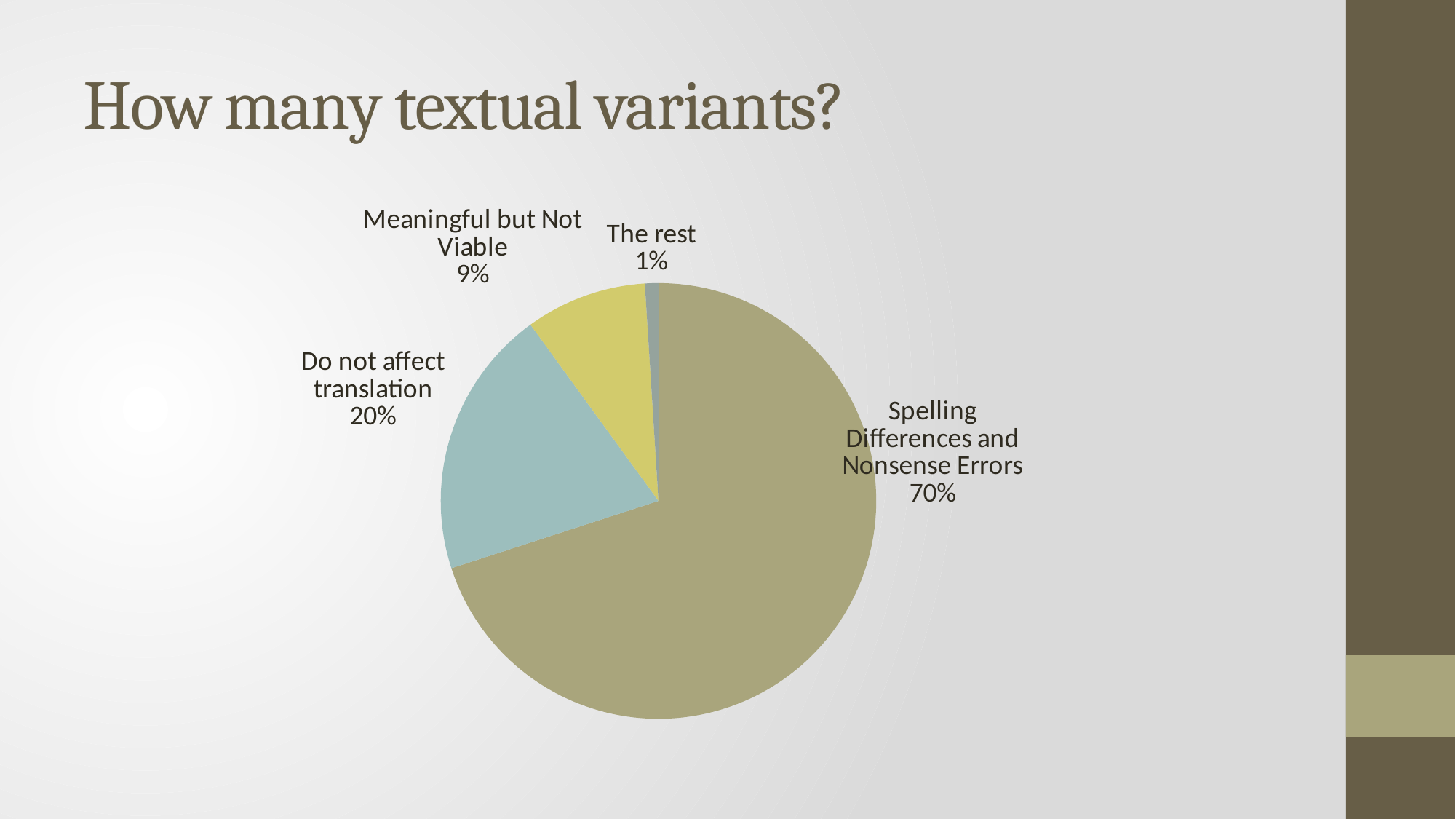
How many slices does the pie chart have? 4 Which slice of the pie is the largest? Spelling Differences and Nonsense Errors What is the difference in percentage points between 'Spelling Differences and Nonsense Errors' and 'Do not affect translation'? 50 Which is larger, the share for 'Meaningful but Not Viable' or the share for 'The rest'? Meaningful but Not Viable What is the title of the slide containing the pie chart? How many textual variants? What share of the pie is labelled 'Meaningful but Not Viable'? 9% What share of the pie is labelled 'Do not affect translation'? 20% What share of the pie is labelled 'The rest'? 1% What kind of chart is shown on the slide? pie chart What is the difference in percentage points between 'Do not affect translation' and 'Meaningful but Not Viable'? 11 Which slice of the pie is the smallest? The rest